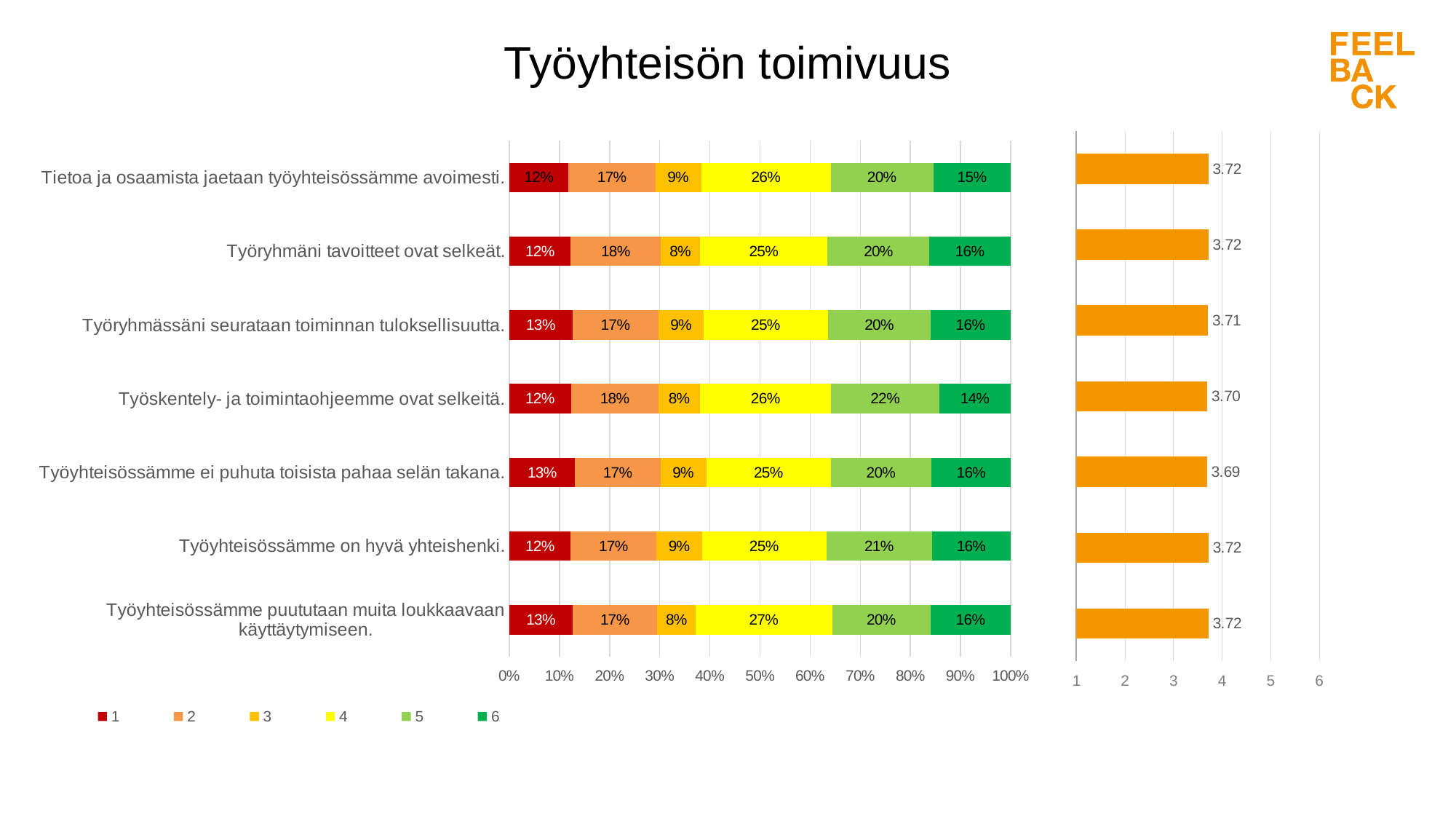
In the bar chart on the right, is the value for "Tietoa ja osaamista jaetaan työyhteisössämme avoimesti." greater or less than 3? greater In the stacked bar chart on the left, for "Työryhmäni tavoitteet ovat selkeät.", which is larger: series 2 or series 3? Series 2 How many series does the legend of the stacked bar chart on the left list? 6 How many statements (categories) are plotted in the stacked bar chart on the left? 7 In the stacked bar chart on the left, which series has the largest share for "Työskentely- ja toimintaohjeemme ovat selkeitä."? 4 In the bar chart on the right, which statement has the lowest value? Työyhteisössämme ei puhuta toisista pahaa selän takana. What is the title of the slide? Työyhteisön toimivuus In the stacked bar chart on the left, what percentage is shown for series 4 for "Työyhteisössämme puututaan muita loukkaavaan käyttäytymiseen."? 27% In the bar chart on the right, what is the value for "Työyhteisössämme ei puhuta toisista pahaa selän takana."? 3.69 In the stacked bar chart on the left, what percentage is shown for series 6 for "Tietoa ja osaamista jaetaan työyhteisössämme avoimesti."? 15% What kind of chart is the chart on the left of the slide? Stacked bar chart In the stacked bar chart on the left, what is the difference between series 5 and series 6 for "Työskentely- ja toimintaohjeemme ovat selkeitä."? 8 percentage points